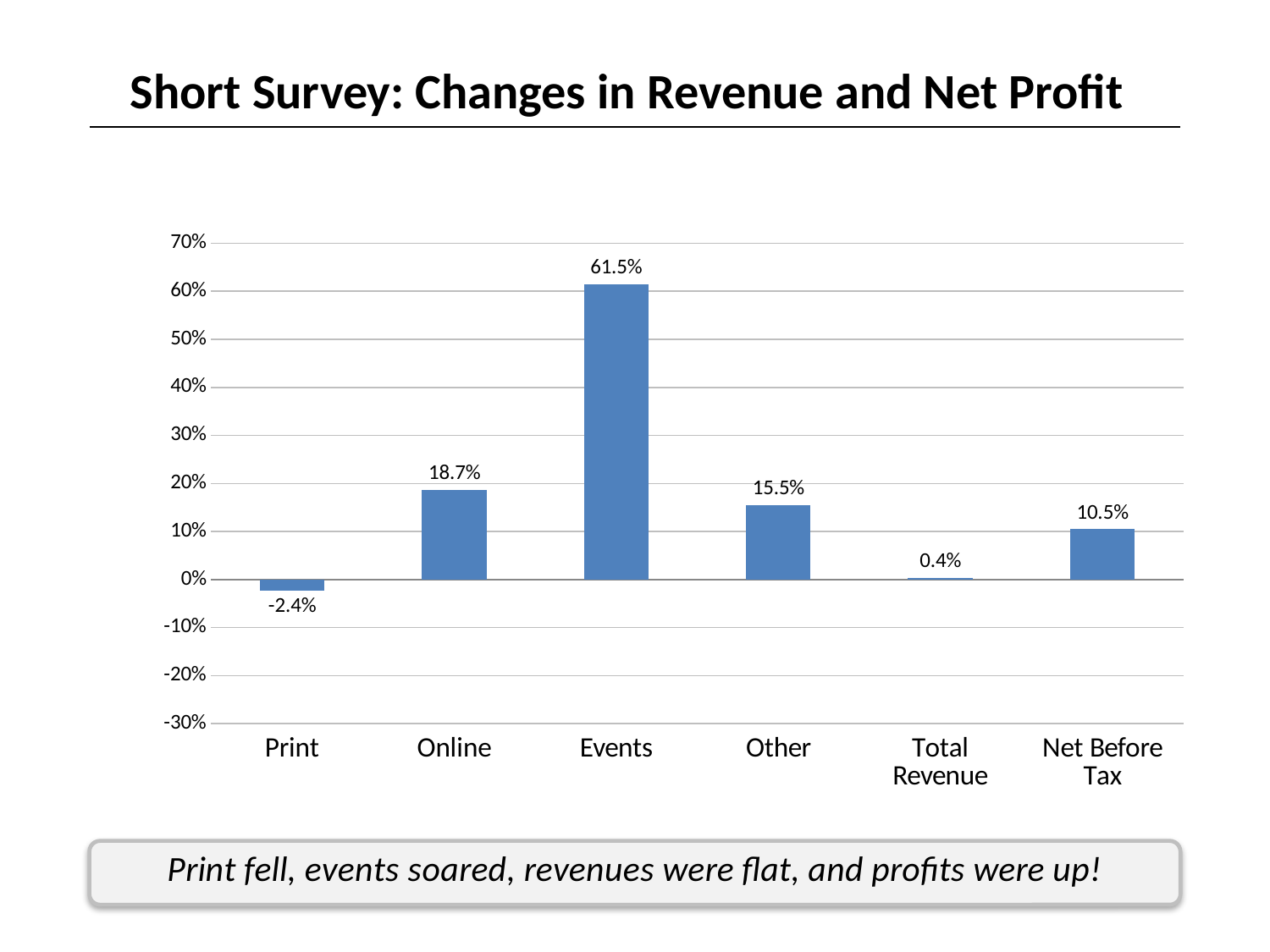
What is the value for Total Revenue? 0.4% What is the difference between the values for Online and Other? 3.2% What is the title of the slide? Short Survey: Changes in Revenue and Net Profit Which category has the lowest value? Print Which category has the highest value? Events What kind of chart is shown on the slide? Bar chart Which is larger, the value for Online or the value for Net Before Tax? Online How many categories are shown on the x axis? 6 What is the value for Events? 61.5% What is the value for Net Before Tax? 10.5% What is the value for Print? -2.4% Is the value for Events greater or less than 50%? greater